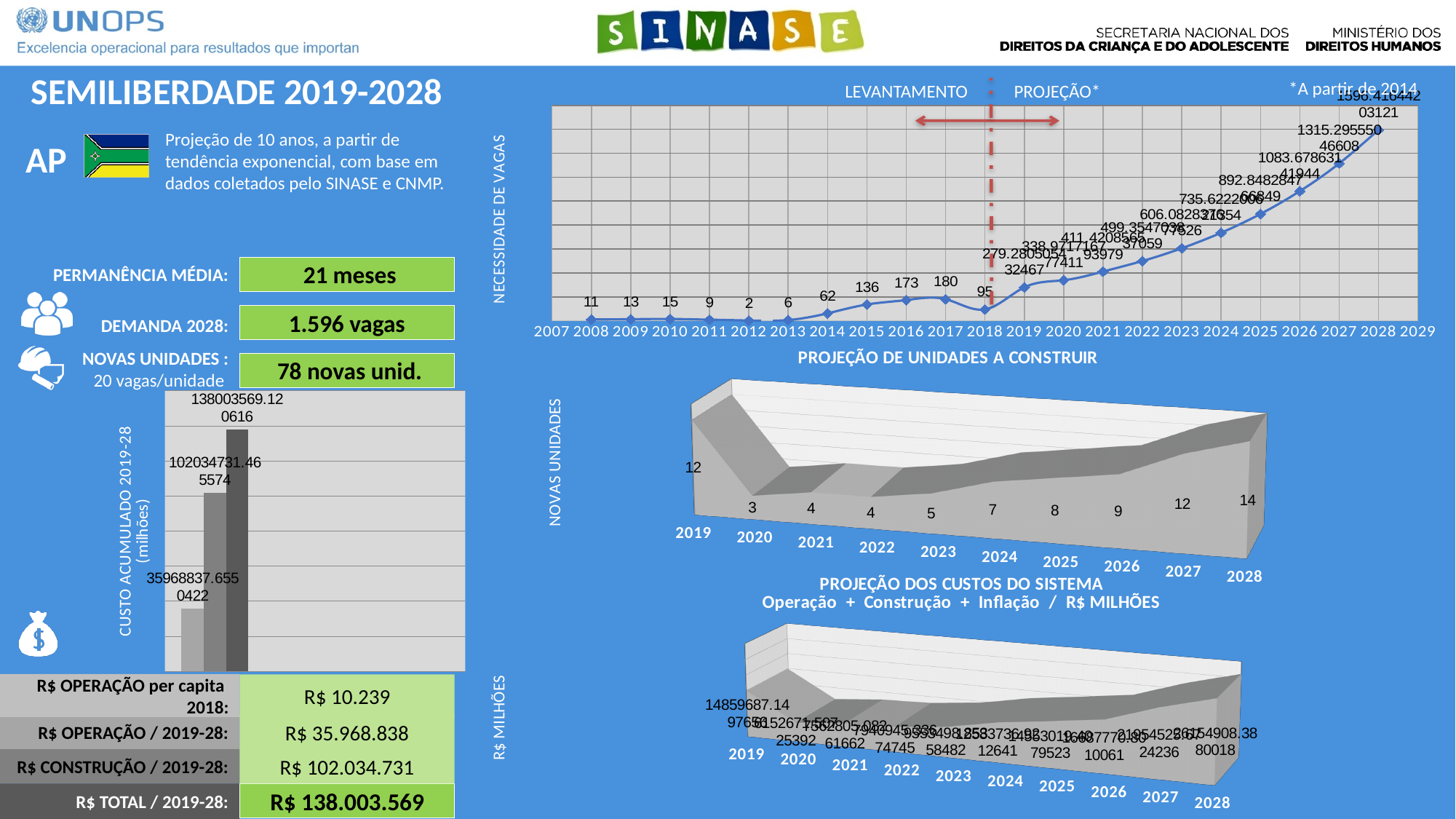
In the top-right line chart (NECESSIDADE DE VAGAS), do the values rise or fall from 2018 to 2028? rise How many years are shown on the x axis of the chart titled PROJEÇÃO DE UNIDADES A CONSTRUIR? 10 In the chart titled PROJEÇÃO DE UNIDADES A CONSTRUIR, what is the difference between the values for 2028 and 2019? 2 In the top-right line chart (NECESSIDADE DE VAGAS), what is the value for 2017? 180 In the chart titled PROJEÇÃO DE UNIDADES A CONSTRUIR, which year has the highest value? 2028 In the top-right line chart (NECESSIDADE DE VAGAS), which year between 2008 and 2018 has the lowest value? 2012 In the top-right line chart (NECESSIDADE DE VAGAS), which is larger, the value for 2014 or the value for 2015? 2015 In the top-right line chart (NECESSIDADE DE VAGAS), what is the difference between the values for 2017 and 2016? 7 In the top-right line chart (NECESSIDADE DE VAGAS), what is the value for 2018? 95 In the chart titled PROJEÇÃO DE UNIDADES A CONSTRUIR, what is the value for 2019? 12 What kind of chart is the CUSTO ACUMULADO 2019-28 chart on the left of the slide? bar chart In the chart titled PROJEÇÃO DE UNIDADES A CONSTRUIR, which year has the lowest value? 2020